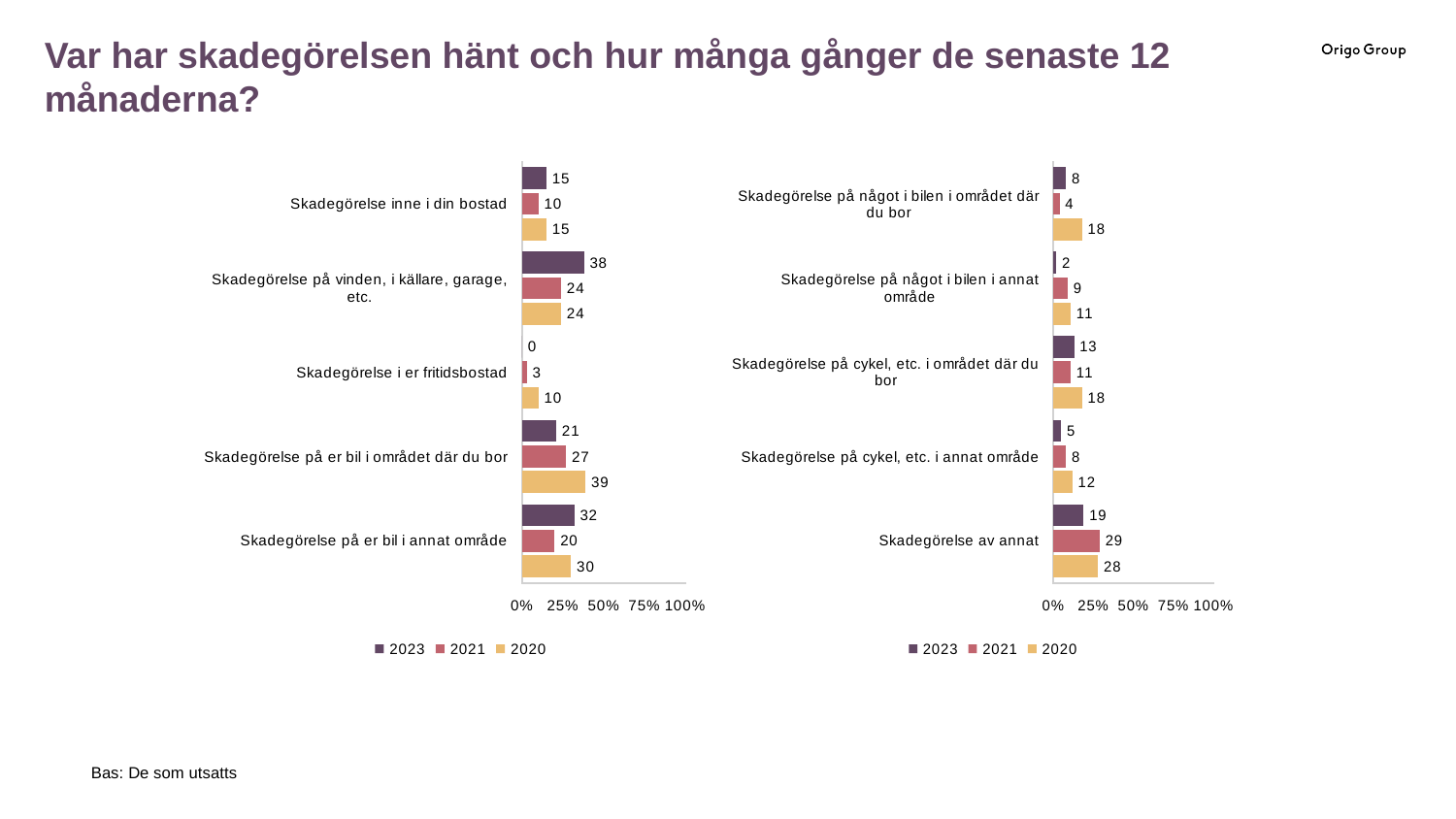
In the right chart, what is the 2021 value for "Skadegörelse av annat"? 29 In the left chart, what is the difference between the 2020 and 2023 values for "Skadegörelse på er bil i området där du bor"? 18 How many series does the legend of the left chart list? 3 In the right chart, what is the difference between the 2020 and 2021 values for "Skadegörelse på något i bilen i området där du bor"? 14 In the left chart, what is the 2020 value for "Skadegörelse på er bil i området där du bor"? 39 What type of chart is the left chart? Bar chart In the left chart, is the 2023 value for "Skadegörelse på er bil i annat område" greater or less than 25%? greater How many categories are shown in the right chart? 5 In the right chart, which category has the lowest 2023 value? Skadegörelse på något i bilen i annat område In the left chart, which category has the highest 2023 value? Skadegörelse på vinden, i källare, garage, etc. In the left chart, what is the 2023 value for "Skadegörelse på vinden, i källare, garage, etc."? 38 In the right chart, which is larger for "Skadegörelse på cykel, etc. i området där du bor": the 2023 value or the 2020 value? 2020